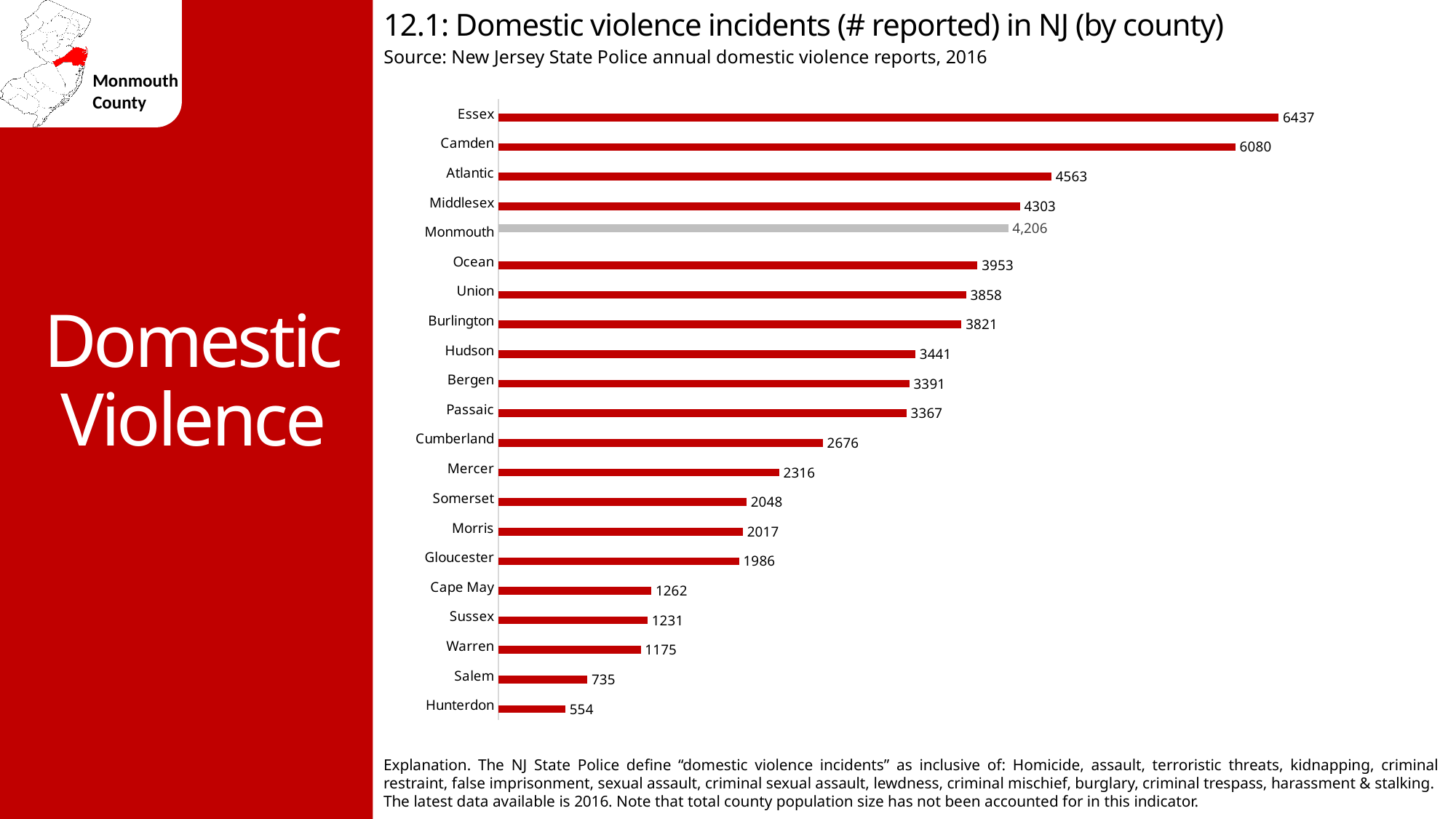
What is the number of domestic violence incidents reported for Essex County? 6437 Which county reported more incidents, Ocean or Union? Ocean How many more incidents were reported in Monmouth than in Ocean? 253 Which county reported more incidents, Cape May or Sussex? Cape May Which county's bar is coloured grey instead of red? Monmouth How many counties are shown in the chart? 21 What type of chart is used to show the domestic violence incidents by county? Bar chart Which county has the lowest number of reported domestic violence incidents? Hunterdon How many more incidents were reported in Essex than in Camden? 357 What is the number of domestic violence incidents reported for Salem County? 735 What is the number of domestic violence incidents reported for Monmouth County? 4,206 Which county has the highest number of reported domestic violence incidents? Essex